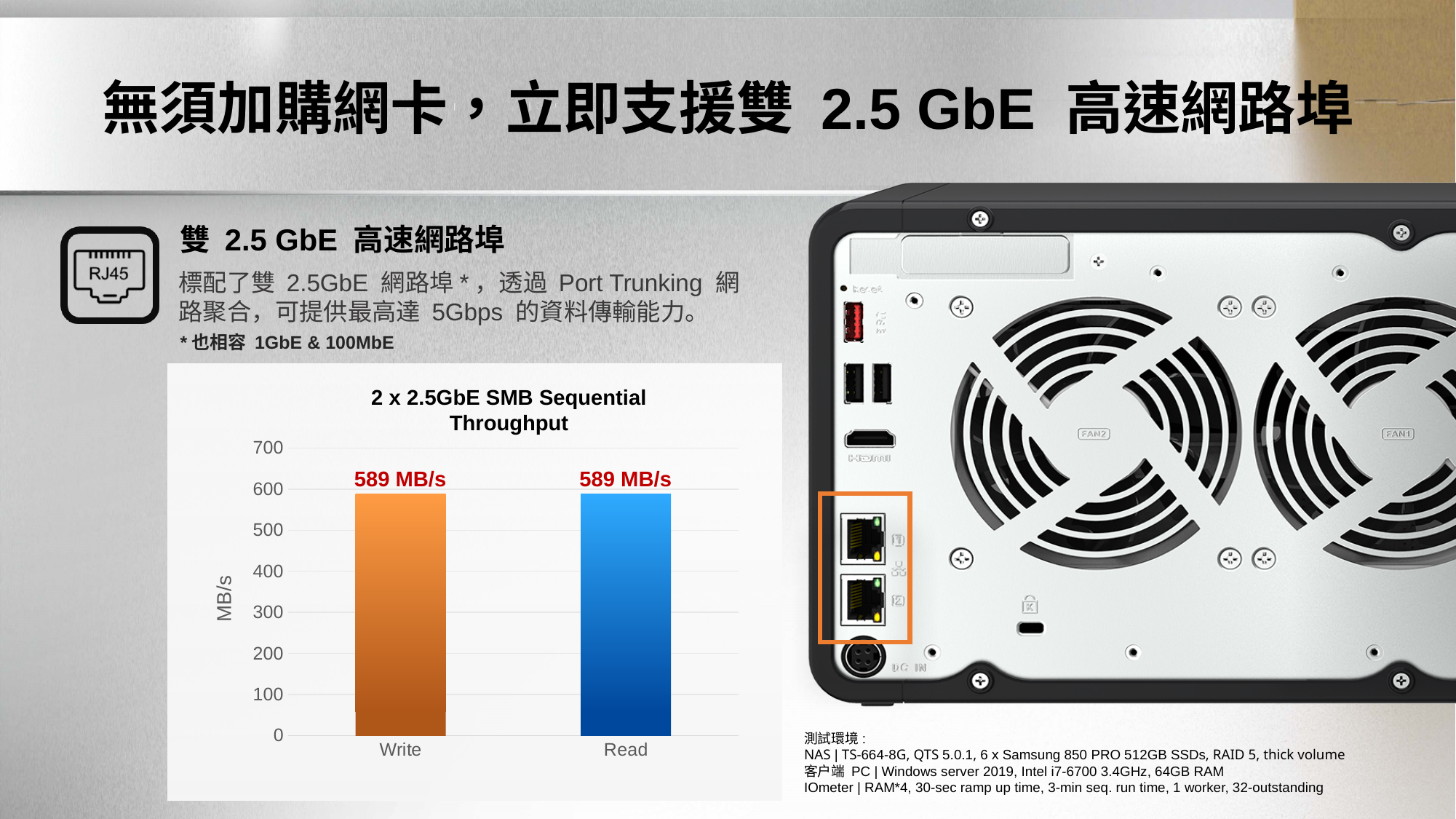
How many categories are plotted in the chart? 2 What is the difference between the Write and Read values? 0 MB/s What is the title of the chart? 2 x 2.5GbE SMB Sequential Throughput What kind of chart is shown on the slide? Bar chart What is the value for Read in the chart? 589 MB/s What is the highest tick value shown on the vertical axis? 700 What is the label on the vertical axis of the chart? MB/s Is the Write value larger than, smaller than, or equal to the Read value? Equal Is the value for Read greater or less than 500? greater Is the value for Write greater or less than 600? less What is the value for Write in the chart? 589 MB/s